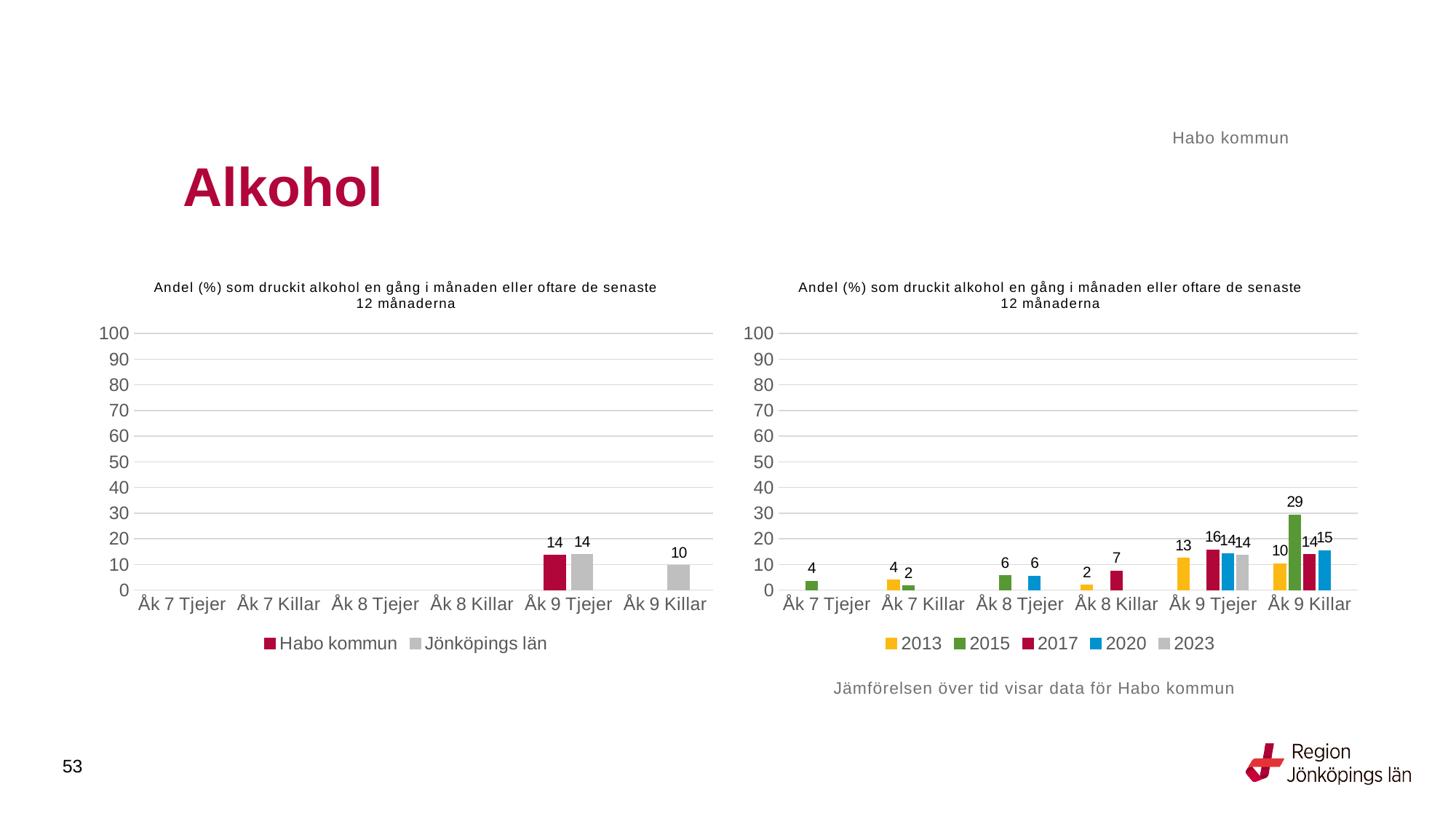
In the left chart, how many series does the legend list? 2 In the right chart, which year has the highest value for Åk 9 Killar? 2015 In the right chart, which is larger for Åk 7 Killar: the 2013 value or the 2015 value? 2013 In the right chart, what is the value for 2017 for Åk 9 Tjejer? 16 In the right chart, what is the value for 2015 for Åk 9 Killar? 29 In the right chart, how many series does the legend list? 5 In the right chart, what is the value for 2013 for Åk 8 Killar? 2 In the left chart, what is the value for Jönköpings län for Åk 9 Killar? 10 In the left chart, what kind of chart is shown? Bar chart In the right chart, how many categories are shown on the x axis? 6 In the right chart, what is the difference between the 2015 and 2013 values for Åk 9 Killar? 19 In the left chart, what is the value for Habo kommun for Åk 9 Tjejer? 14